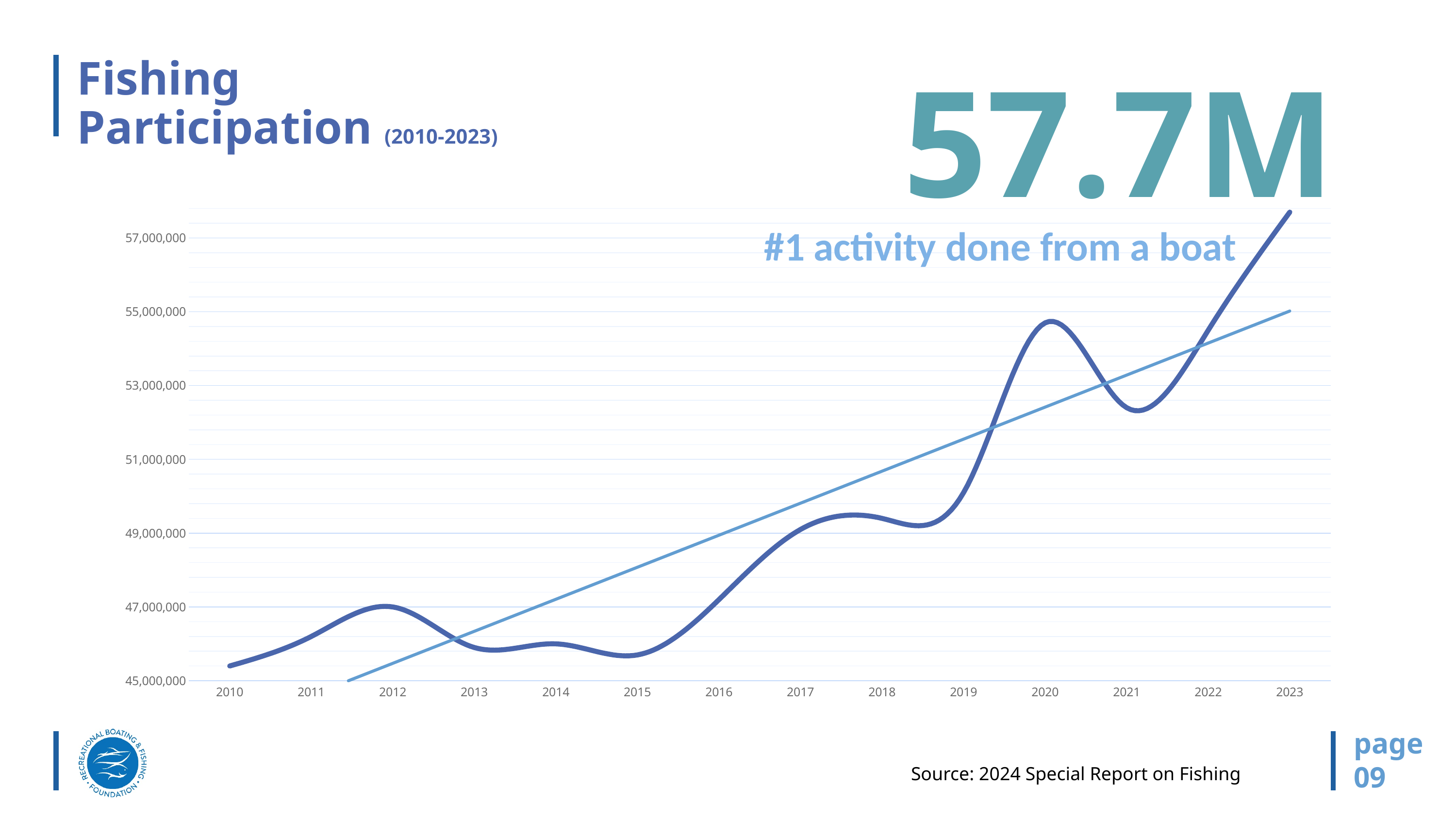
What is the title of the chart on the slide? Fishing Participation (2010-2023) What kind of chart is shown on the slide? line chart How many years are plotted along the x axis of the chart? 14 Is the value for 2010 greater or less than 47,000,000? less Is the value for 2021 greater or less than 53,000,000? less Is the value for 2023 greater or less than 57,000,000? greater Do the fishing participation values generally rise or fall from 2010 to 2023? rise Which year has the larger fishing participation, 2020 or 2021? 2020 Which year has the highest fishing participation on the chart? 2023 What fishing participation figure is highlighted in large text on the slide? 57.7M Which year has the larger fishing participation, 2012 or 2013? 2012